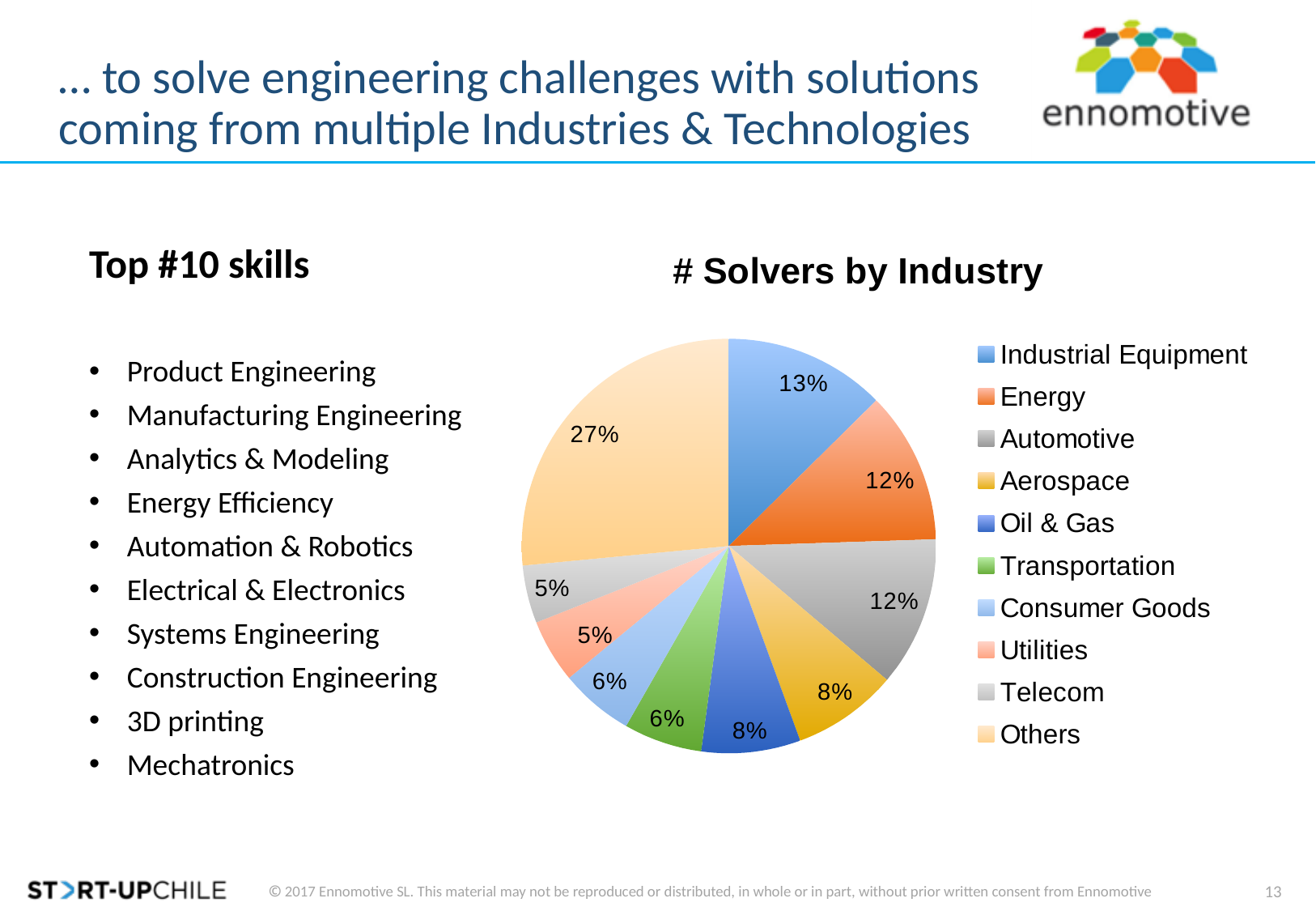
Excluding Others, which industry has the largest share in the '# Solvers by Industry' pie chart? Industrial Equipment What is the title of the pie chart on the slide? # Solvers by Industry What type of chart is shown under the title '# Solvers by Industry'? pie chart Which category has the largest slice in the '# Solvers by Industry' pie chart? Others In the '# Solvers by Industry' pie chart, what share do Industrial Equipment solvers represent? 13% How many categories does the legend of the '# Solvers by Industry' pie chart list? 10 In the '# Solvers by Industry' pie chart, what percentage is shown for Transportation? 6% In the '# Solvers by Industry' pie chart, what percentage is shown for Aerospace? 8% In the '# Solvers by Industry' pie chart, what is the difference in percentage points between Others and Industrial Equipment? 14 In the '# Solvers by Industry' pie chart, what percentage is labelled for Energy? 12% In the '# Solvers by Industry' pie chart, which is larger: the share for Oil & Gas or the share for Utilities? Oil & Gas In the '# Solvers by Industry' pie chart, what percentage is shown for Others? 27%